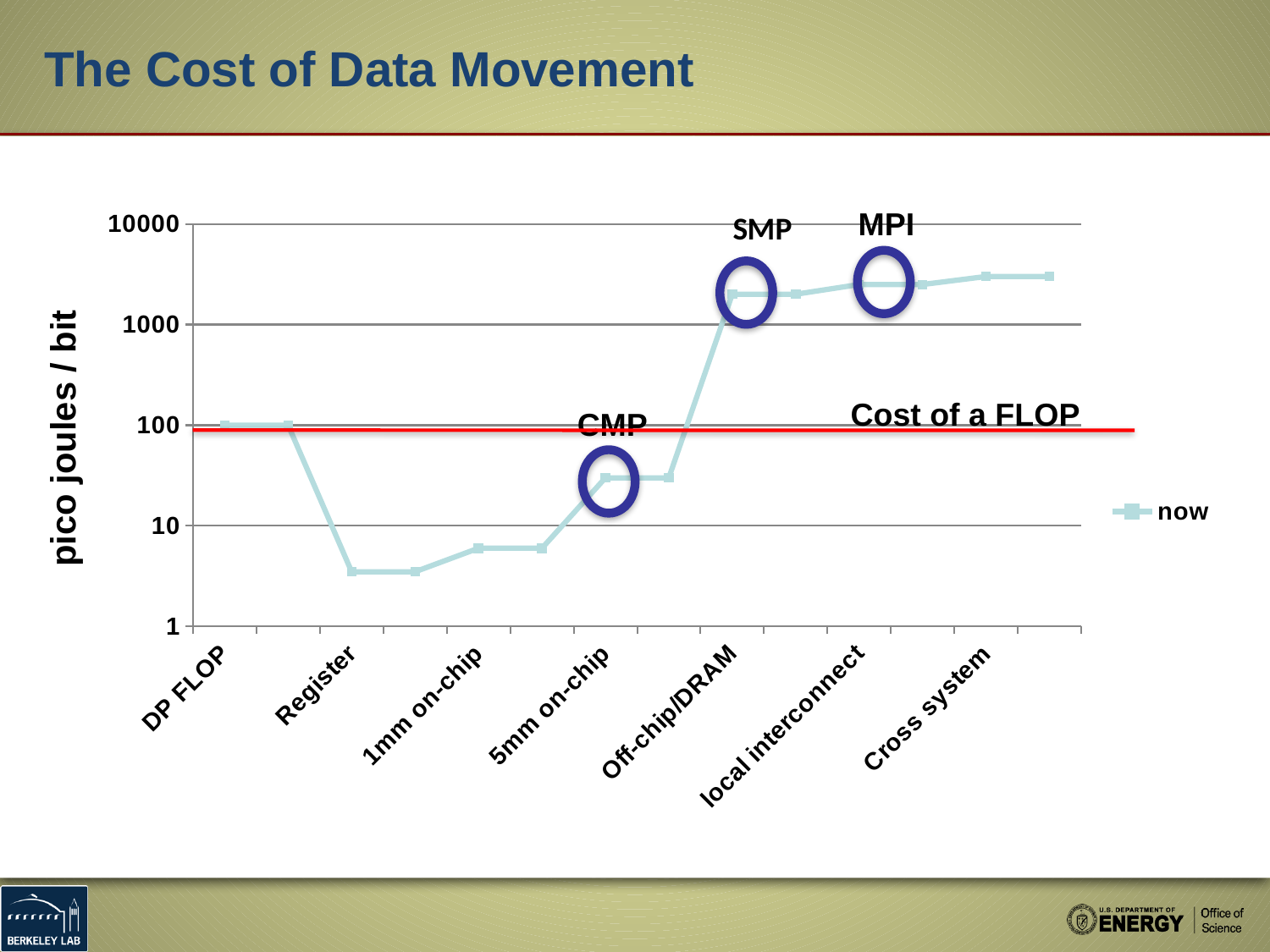
What is the name of the series in the legend? now Is the value for local interconnect greater or less than 1000? greater Is the value for Cross system greater or less than 1000? greater Is the value for 1mm on-chip greater or less than 10? less How many series does the legend list? 1 What is the label of the y axis? pico joules / bit What kind of chart is shown on the slide? line chart How many categories are labelled on the x axis? 7 Do the values rise or fall from 5mm on-chip to Cross system? rise Which category has the highest value? Cross system Which category has the lowest value? Register Which is larger, the value for Cross system or the value for 5mm on-chip? Cross system